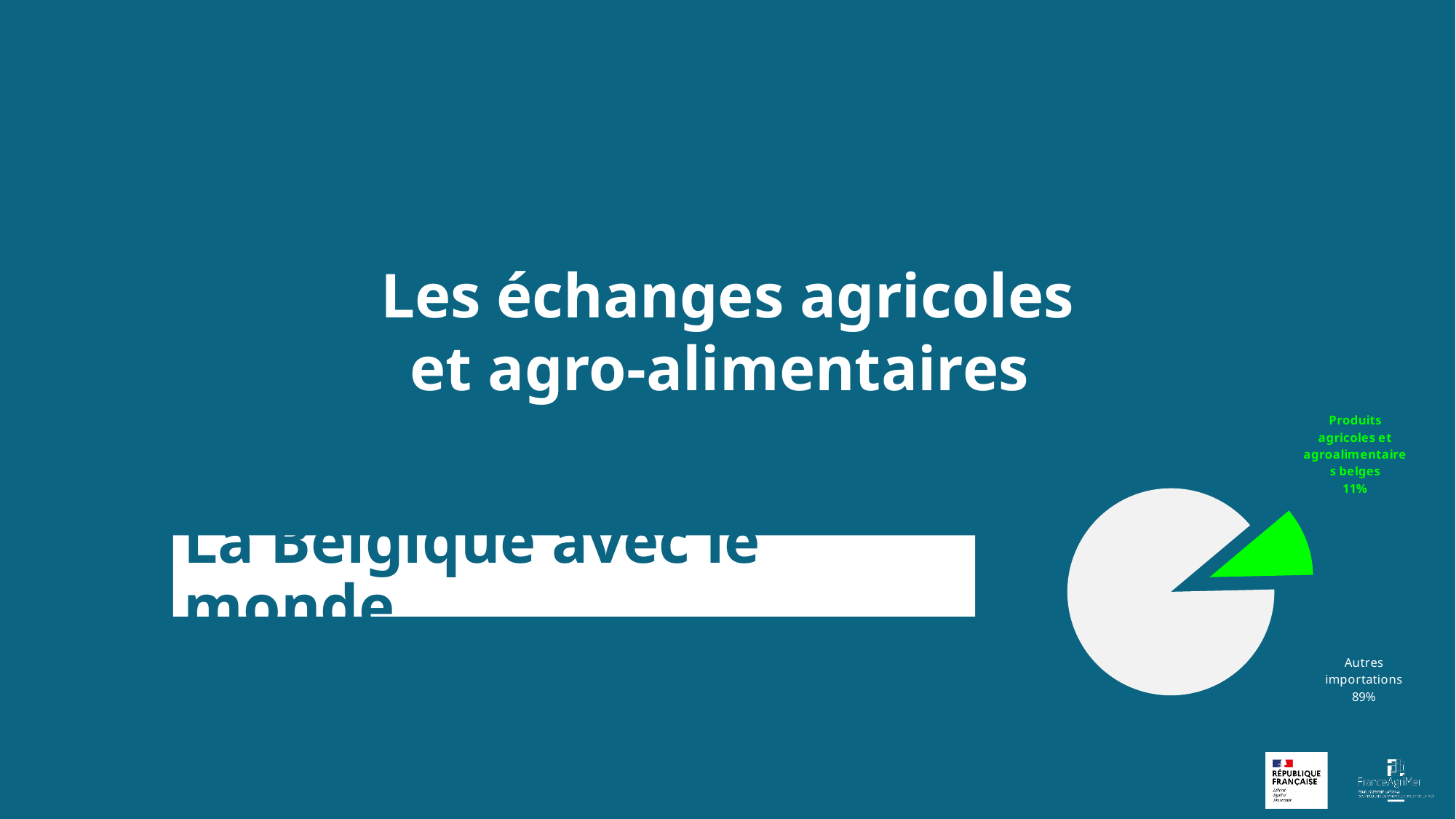
What colour is the "Autres importations" slice? light grey Which slice of the pie chart is the largest? Autres importations Which is larger: the "Autres importations" slice or the "Produits agricoles et agroalimentaires belges" slice? Autres importations How many slices does the pie chart have? 2 What is the total of the two slice percentages shown on the pie chart? 100% Which slice of the pie chart is the smallest? Produits agricoles et agroalimentaires belges What share of the pie is labelled "Autres importations"? 89% What colour is the "Produits agricoles et agroalimentaires belges" slice? green What kind of chart is shown on the slide? pie chart What is the difference in percentage points between the "Autres importations" slice and the "Produits agricoles et agroalimentaires belges" slice? 78 What share of the pie is labelled "Produits agricoles et agroalimentaires belges"? 11%